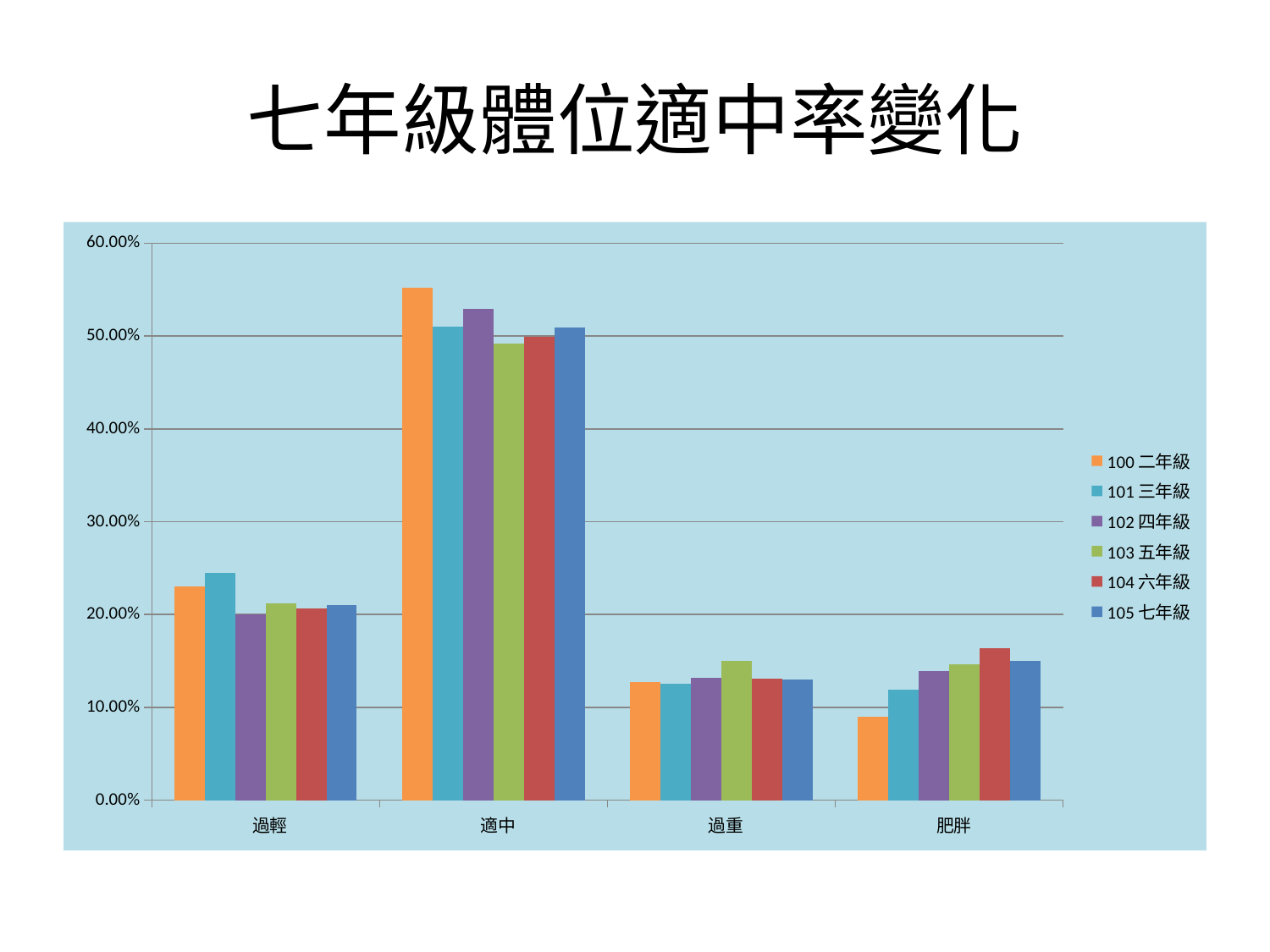
In the 過輕 category, which series has the highest value? 101 三年級 In the 肥胖 category, which series has the lowest value? 100 二年級 Is the value for 100 二年級 in the 適中 category greater or less than 50.00%? greater In the 肥胖 category, which series has the highest value? 104 六年級 How many categories are shown on the x axis? 4 In the 肥胖 category, which is larger: the value for 100 二年級 or the value for 104 六年級? 104 六年級 What kind of chart is shown on the slide? bar chart What is the title of the slide? 七年級體位適中率變化 How many series does the legend list? 6 Is the value for 100 二年級 in the 肥胖 category greater or less than 10.00%? less Which category has the highest value for the 100 二年級 series? 適中 Is the value for 101 三年級 in the 過輕 category greater or less than 20.00%? greater